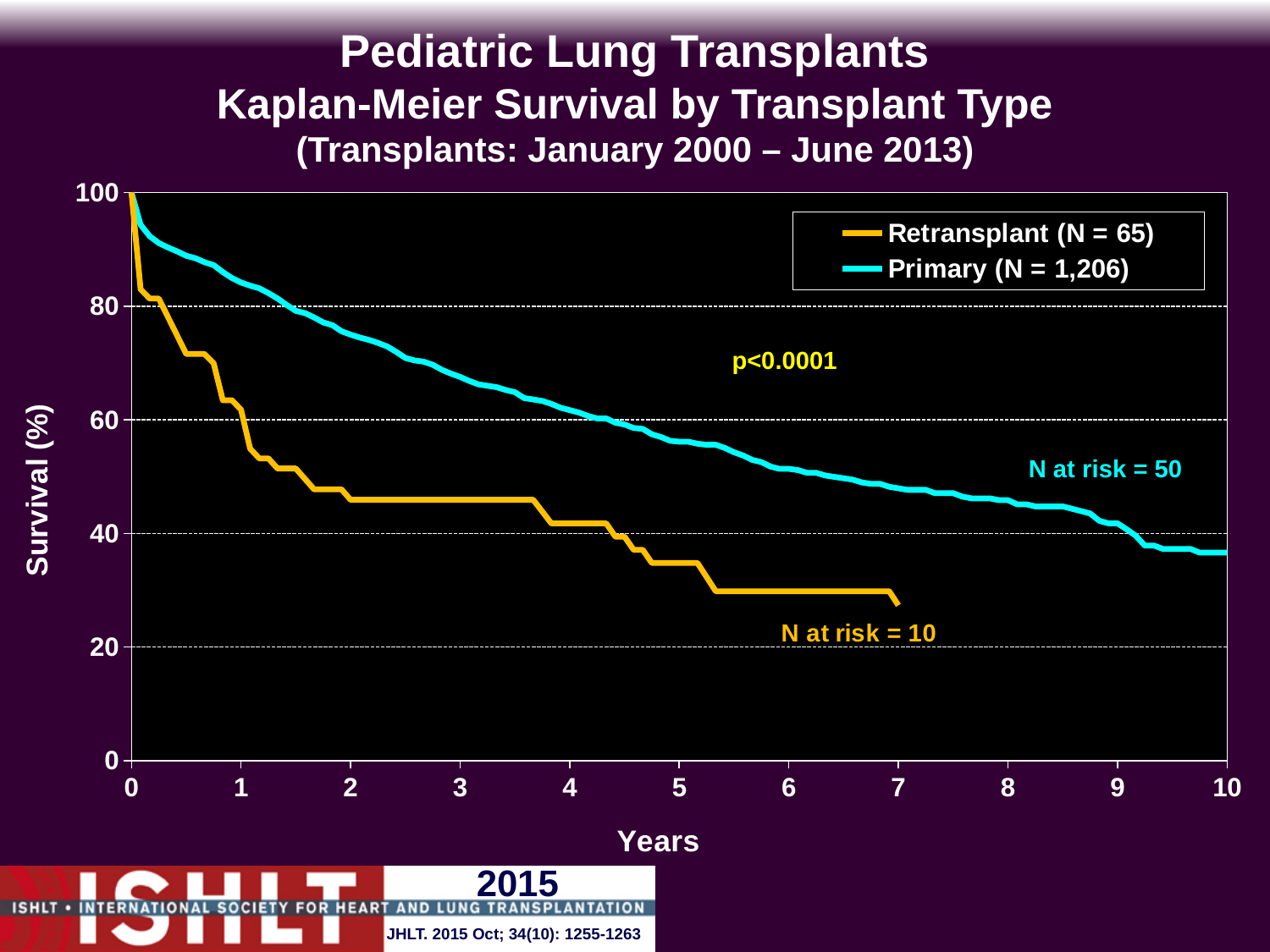
How many series does the legend list? 2 What is the N for the Primary group shown in the legend? 1,206 What is the N at risk shown for the Retransplant curve? 10 What is the N for the Retransplant group shown in the legend? 65 What is the N at risk shown for the Primary curve? 50 Is the Retransplant survival at 5 years greater or less than 40? less What kind of chart is shown on the slide? line chart Is the Primary survival at 2 years greater or less than 60? greater What p-value is printed on the chart? p<0.0001 What is the label of the x axis? Years Do the survival curves rise or fall as years increase? fall At 5 years, which group has higher survival, Primary or Retransplant? Primary